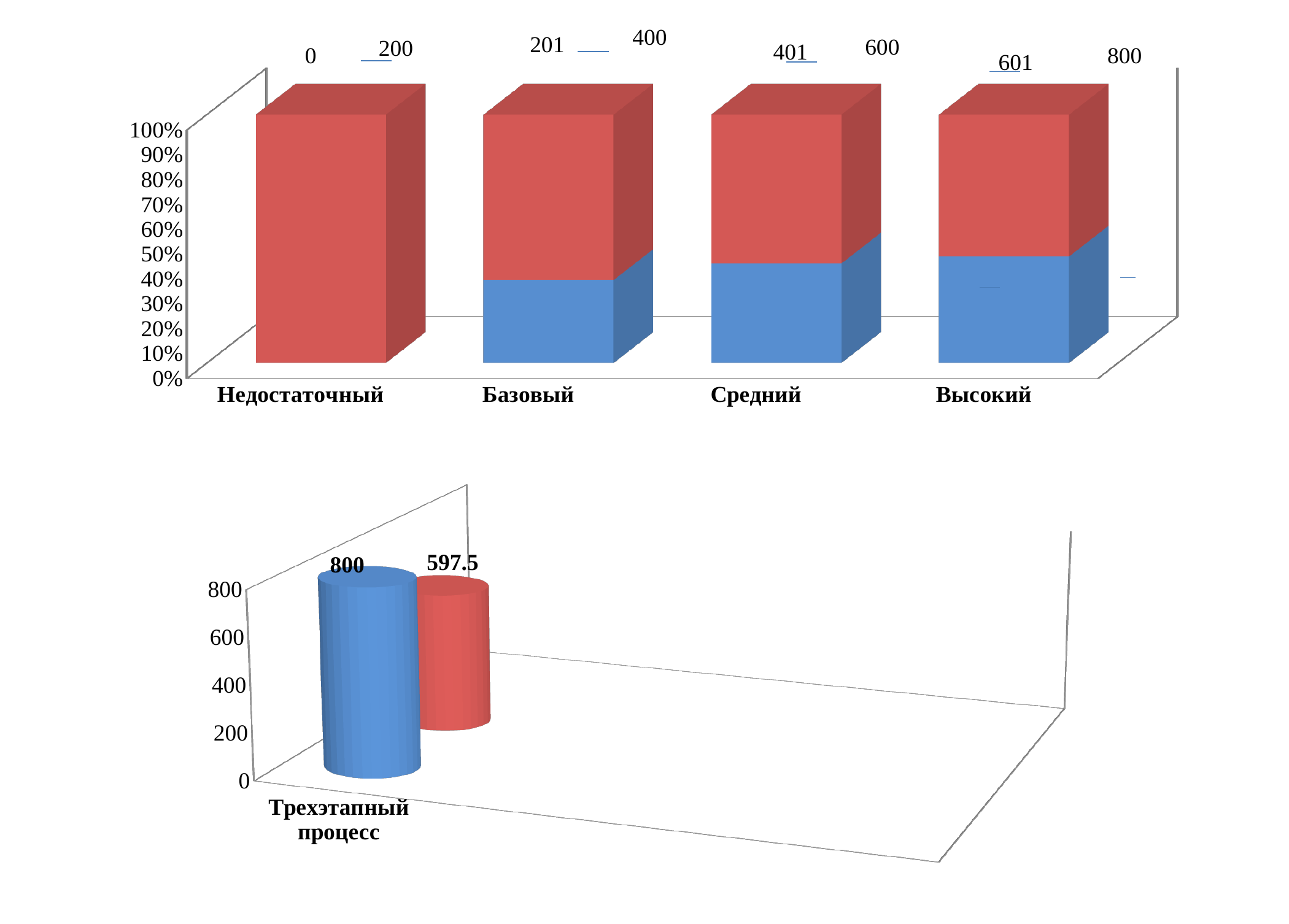
What kind of chart is the top chart? Stacked bar chart In the top chart, what range label is printed above the Высокий bar? 601 — 800 In the bottom chart, which bar is larger, the blue one or the red one? the blue one In the top chart, is the blue portion for Средний greater or less than 30%? greater In the bottom chart, what is the value of the blue bar for Трехэтапный процесс? 800 In the bottom chart, what is the value of the red bar for Трехэтапный процесс? 597.5 In the bottom chart, what is the difference between the blue bar and the red bar? 202.5 In the top chart, does the blue portion rise or fall moving from Недостаточный to Высокий? rise In the top chart, is the blue portion for Базовый greater or less than 50%? less What kind of chart is the bottom chart? Bar chart In the top chart, how many categories are shown on the x axis? 4 In the top chart, which category has no blue portion at all? Недостаточный